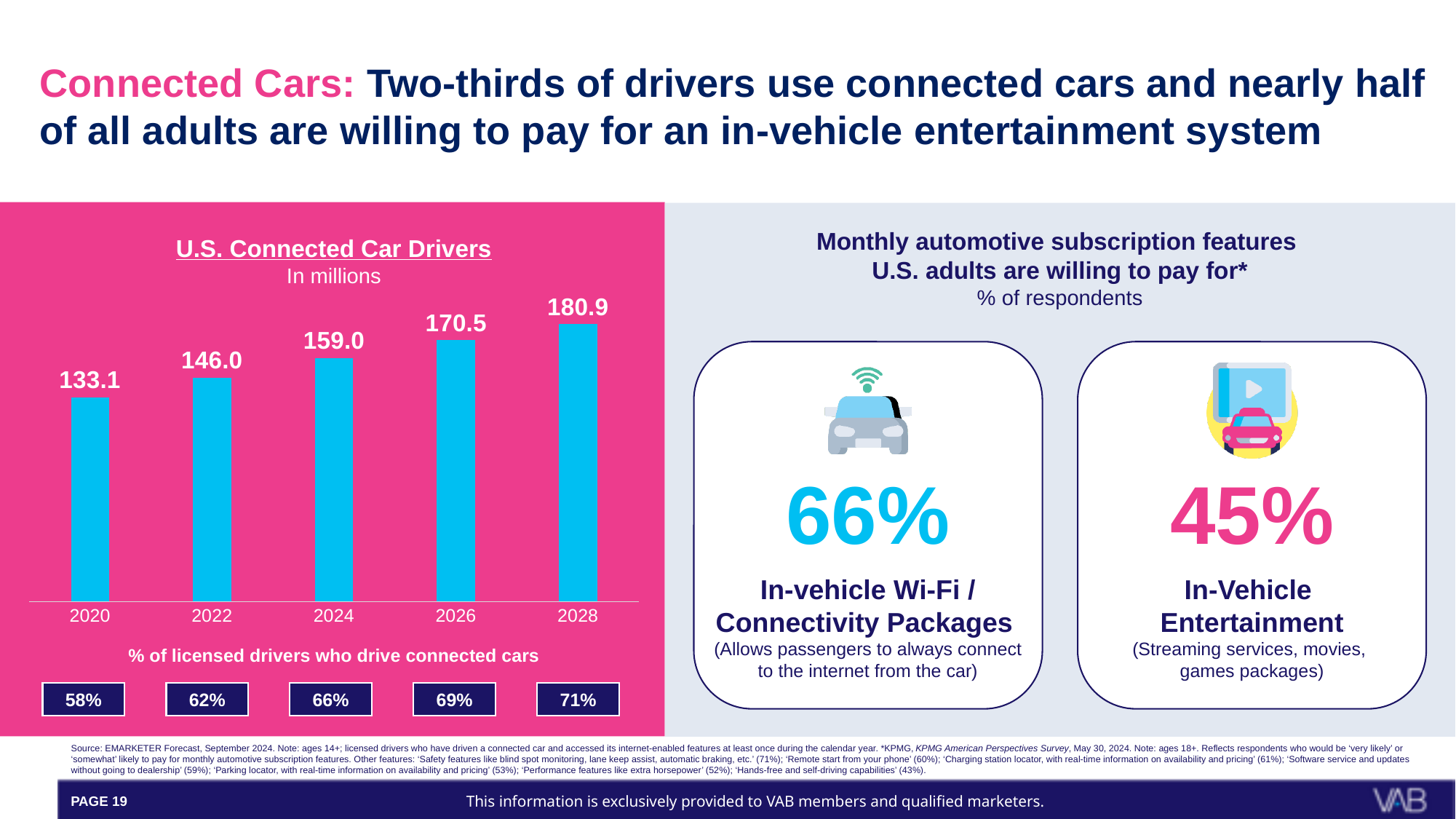
In the U.S. Connected Car Drivers chart, which year has the lowest value? 2020 In the U.S. Connected Car Drivers chart, which is larger, the value for 2022 or the value for 2026? 2026 In the U.S. Connected Car Drivers chart, which year has the highest value? 2028 Below the U.S. Connected Car Drivers chart, what percentage of licensed drivers drive connected cars in 2026? 69% In the U.S. Connected Car Drivers chart, what is the value for 2020? 133.1 What unit is the U.S. Connected Car Drivers chart measured in, according to its subtitle? In millions In the U.S. Connected Car Drivers chart, what is the difference between the 2028 and 2020 values? 47.8 In the U.S. Connected Car Drivers chart, what is the difference between the 2026 and 2024 values? 11.5 How many years are shown in the U.S. Connected Car Drivers chart? 5 What kind of chart is the U.S. Connected Car Drivers chart? Bar chart In the U.S. Connected Car Drivers chart, do the values rise or fall from 2020 to 2028? Rise In the U.S. Connected Car Drivers chart, what is the value for 2024? 159.0